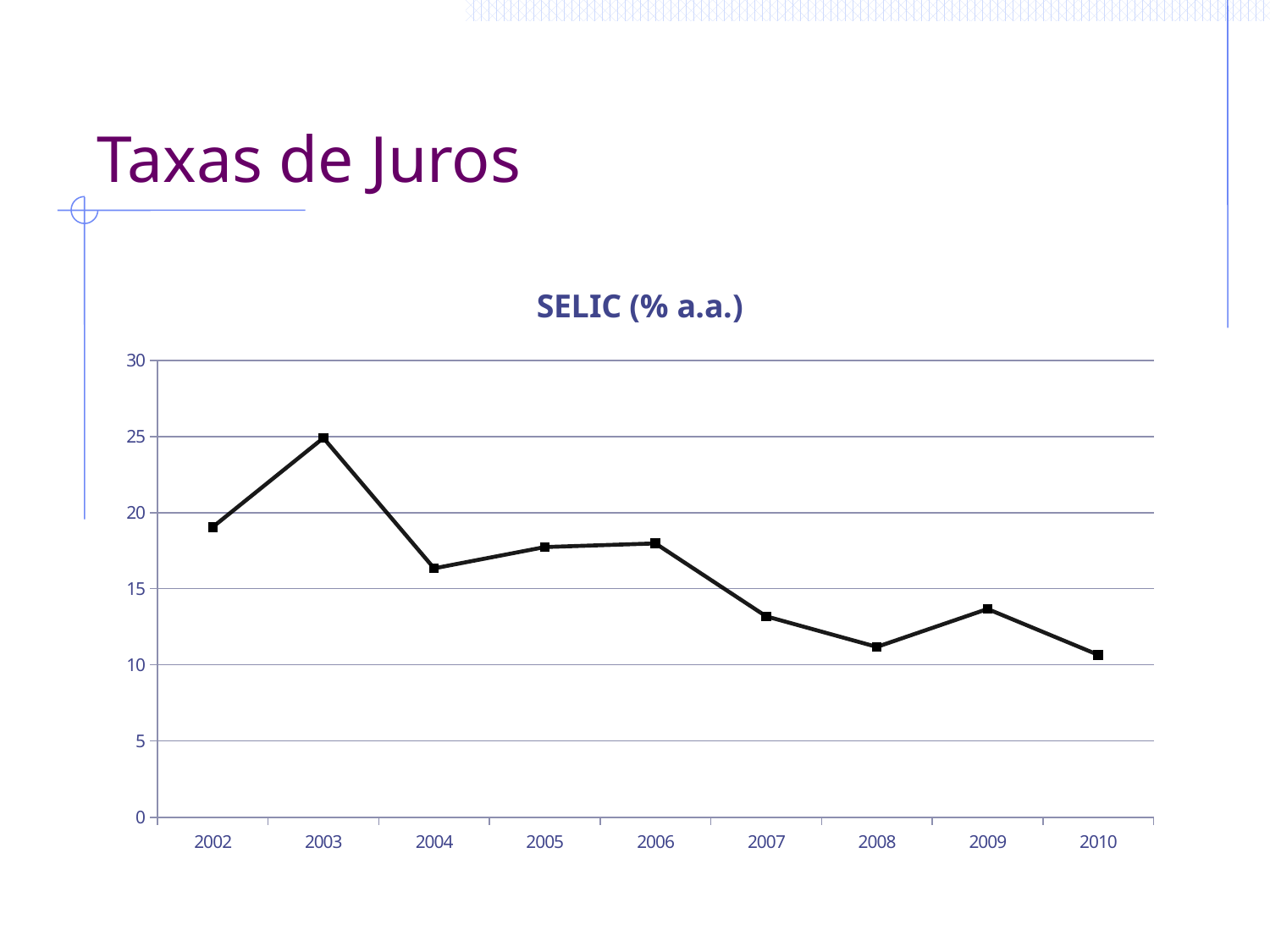
Is the SELIC value for 2010 greater or less than 15? less Is the SELIC value for 2002 greater or less than 15? greater In which year is the SELIC rate highest? 2003 Is the SELIC value for 2007 greater or less than 15? less Which year has a higher SELIC rate, 2006 or 2008? 2006 Which year has a higher SELIC rate, 2002 or 2004? 2002 How many years are plotted on the x axis of the chart? 9 What type of chart is shown on the slide? line chart Overall, does the SELIC rate rise or fall from 2003 to 2010? fall What is the title of the chart? SELIC (% a.a.)